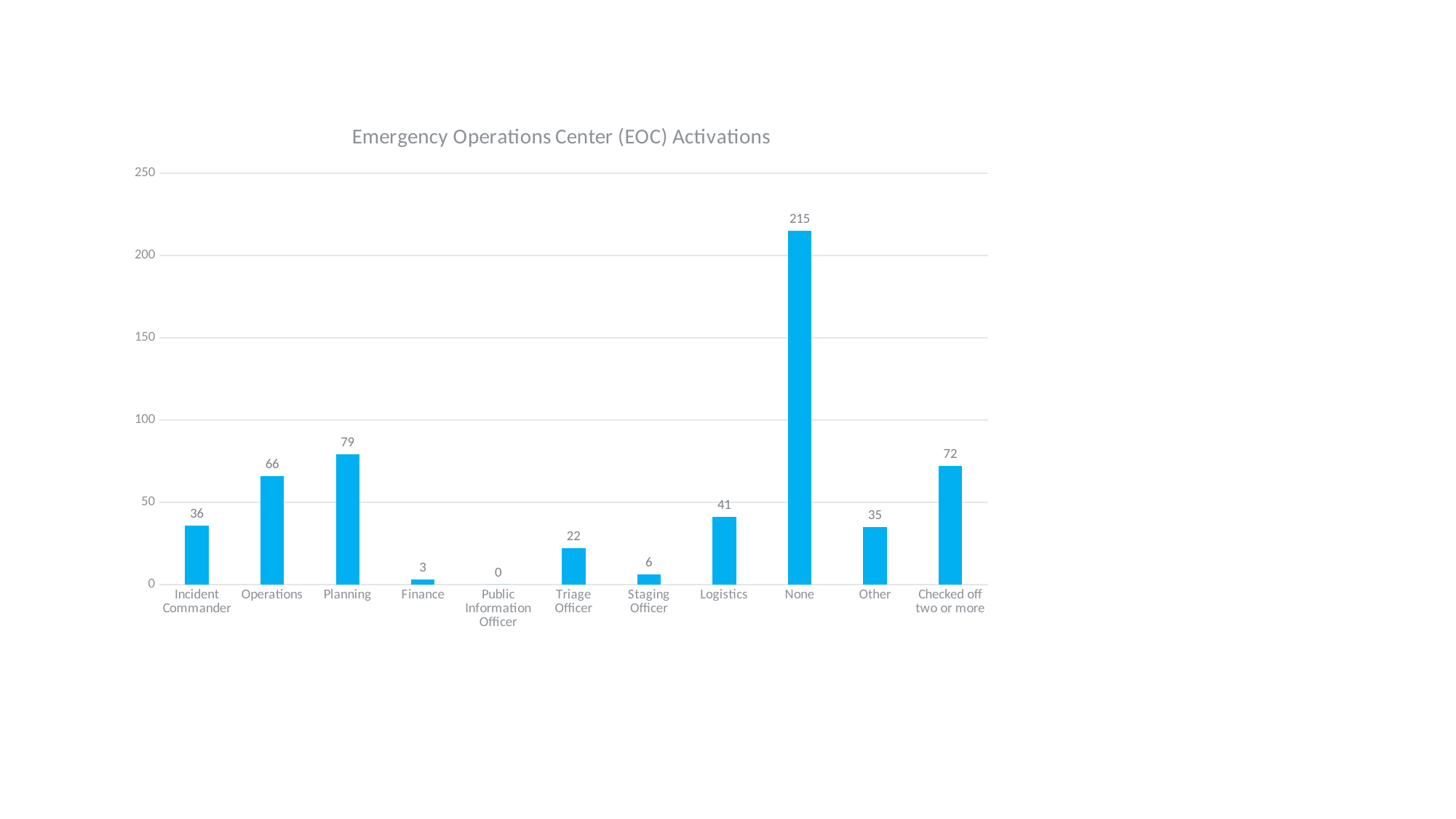
Is the value for None greater or less than 200? greater What is the difference between the values for Incident Commander and Other? 1 What is the value for Public Information Officer? 0 Which is larger, the value for Operations or the value for Checked off two or more? Checked off two or more What is the value for Planning? 79 Which category has the lowest value? Public Information Officer Which category has the highest value? None How many categories are shown on the x axis? 11 What is the difference between the values for None and Planning? 136 What kind of chart is shown on the slide? bar chart What is the title of the chart? Emergency Operations Center (EOC) Activations What is the value for Logistics? 41